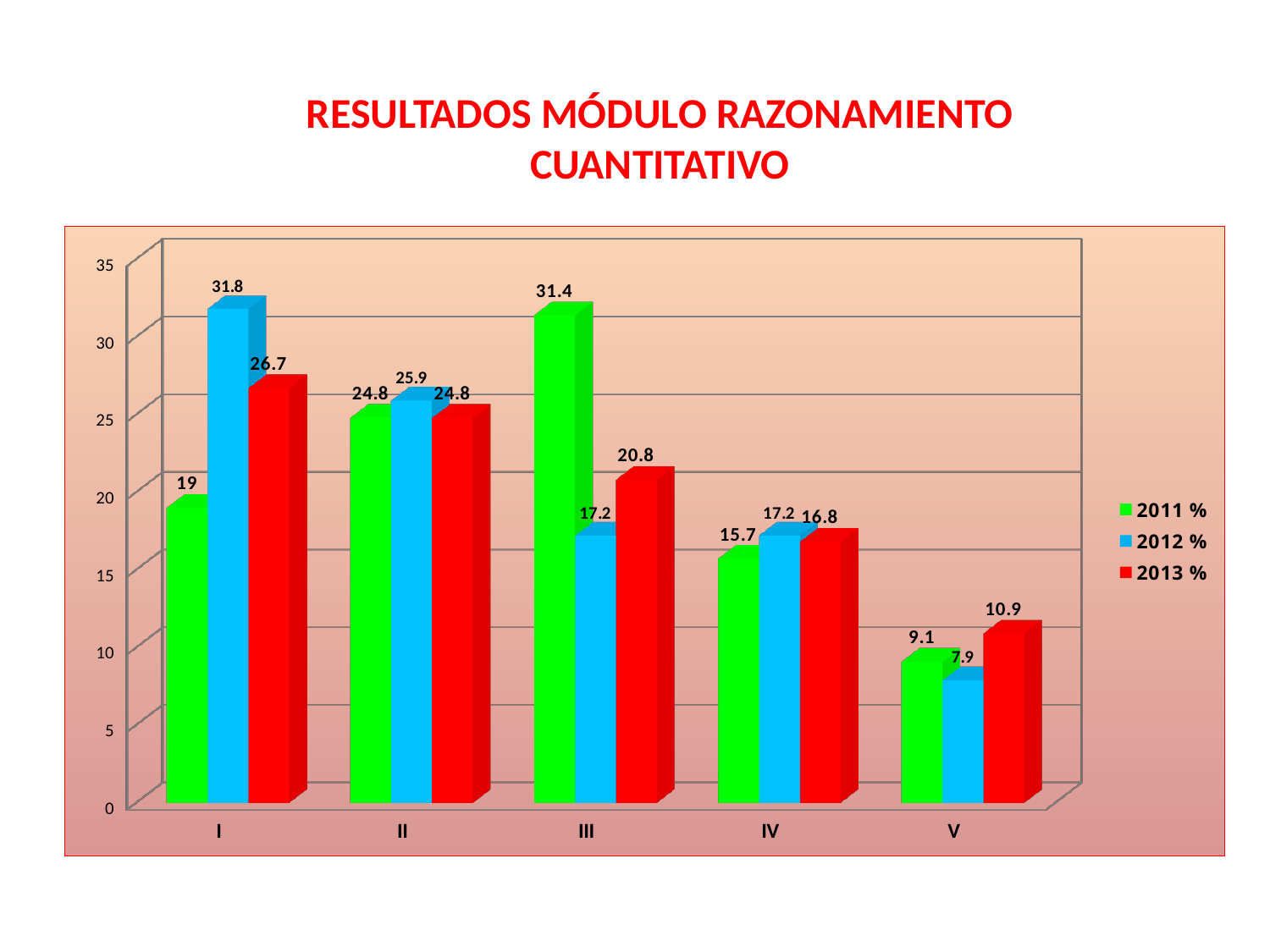
Do the 2013 % values rise or fall from category III to category V? fall What is the difference between the 2011 % and 2012 % values for category III? 14.2 How many categories are shown on the x axis? 5 Which is larger for category I: the 2011 % value or the 2013 % value? 2013 % What is the value for category III in the 2013 % series? 20.8 What is the value for category I in the 2012 % series? 31.8 What is the title of the chart? RESULTADOS MÓDULO RAZONAMIENTO CUANTITATIVO Which category has the lowest value in the 2012 % series? V Which category has the highest value in the 2011 % series? III What is the value for category V in the 2011 % series? 9.1 How many series does the legend list? 3 What kind of chart is shown on the slide? bar chart